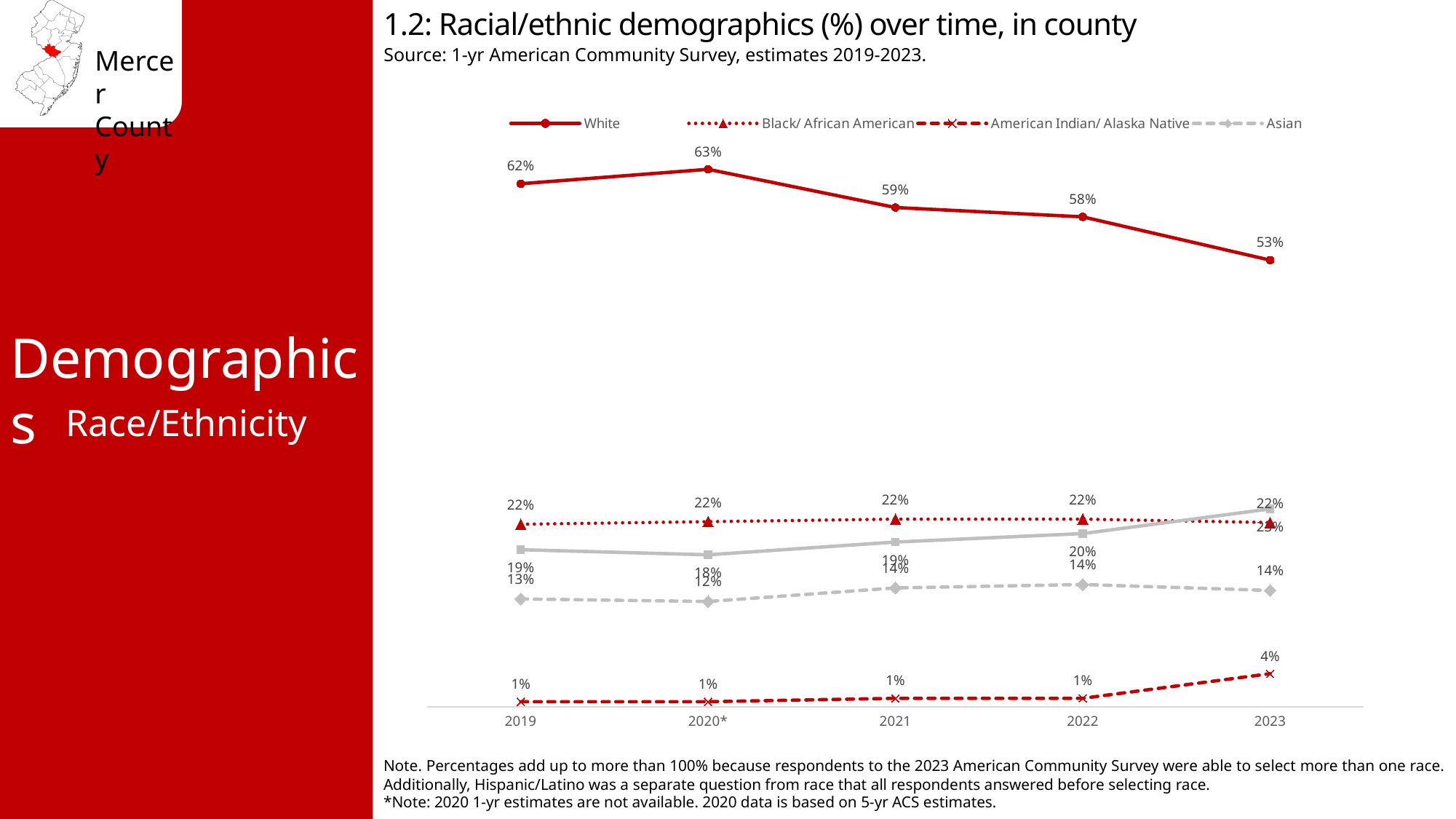
What is the value for White in 2023? 53% In which year is the White series at its highest? 2020* Which is larger in 2019, the value for White or the value for Asian? White What is the value for White in 2019? 62% Does the White series rise or fall from 2020* to 2023? fall How many series does the legend list? 4 In which year is the White series at its lowest? 2023 What is the value for American Indian/ Alaska Native in 2023? 4% What kind of chart is shown on the slide? line chart By how many percentage points did the White value change from 2019 to 2023? 9 percentage points What is the value for Black/ African American in 2021? 22% What is the value for Asian in 2020*? 12%